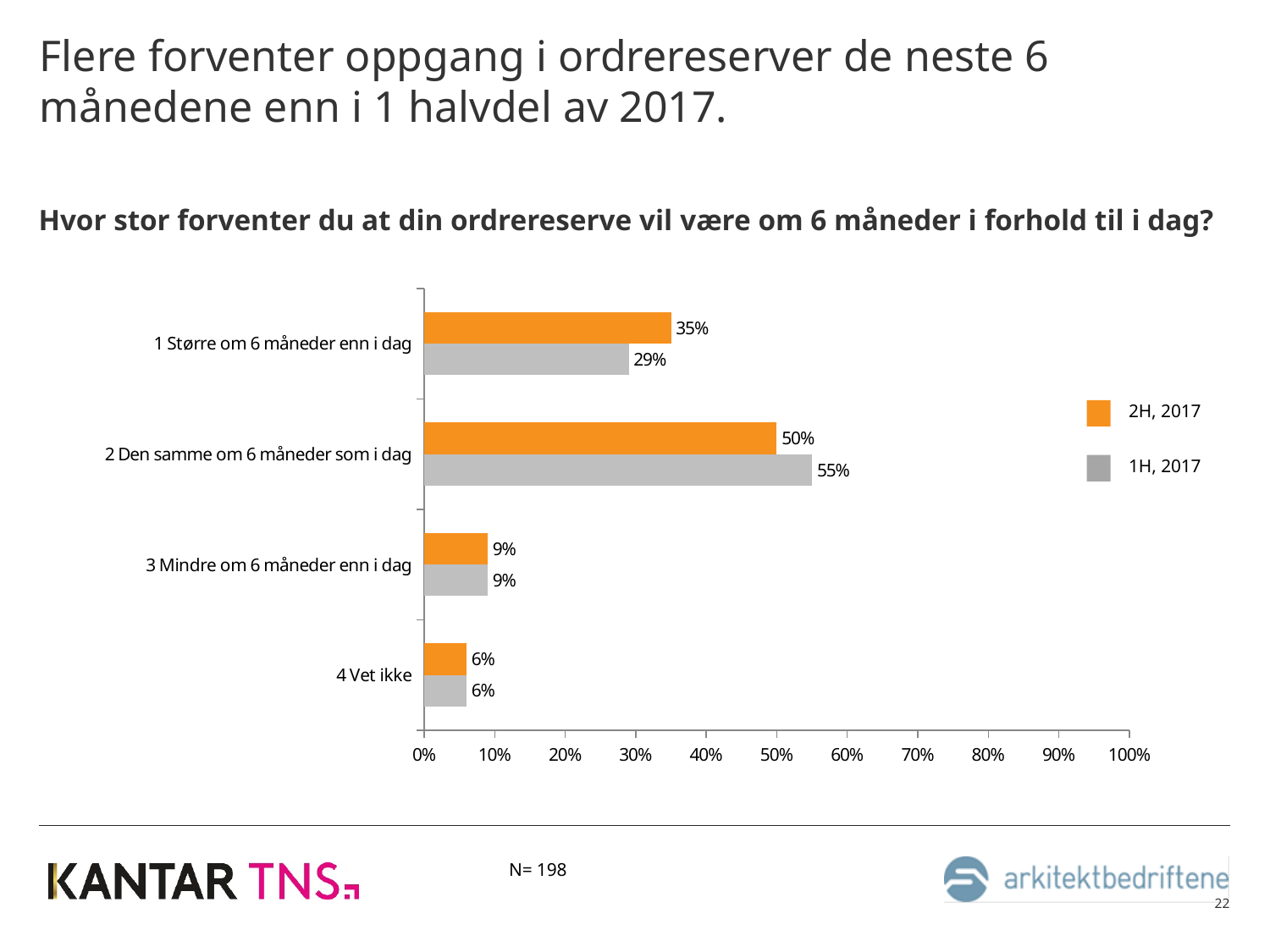
What is the value for "2 Den samme om 6 måneder som i dag" in the 1H, 2017 series? 55% What is the difference between the 2H, 2017 and 1H, 2017 values for "1 Større om 6 måneder enn i dag"? 6% Is the 1H, 2017 value for "1 Større om 6 måneder enn i dag" greater or less than 20%? greater How many categories are shown on the chart? 4 What kind of chart is shown on the slide? Bar chart What is the value for "4 Vet ikke" in the 2H, 2017 series? 6% What is the value for "1 Større om 6 måneder enn i dag" in the 2H, 2017 series? 35% How many series does the legend list? 2 For "2 Den samme om 6 måneder som i dag", which series has the larger value, 2H, 2017 or 1H, 2017? 1H, 2017 Which category has the highest value in the 2H, 2017 series? 2 Den samme om 6 måneder som i dag Which category has the lowest value in the 1H, 2017 series? 4 Vet ikke Which colour represents the 2H, 2017 series? Orange